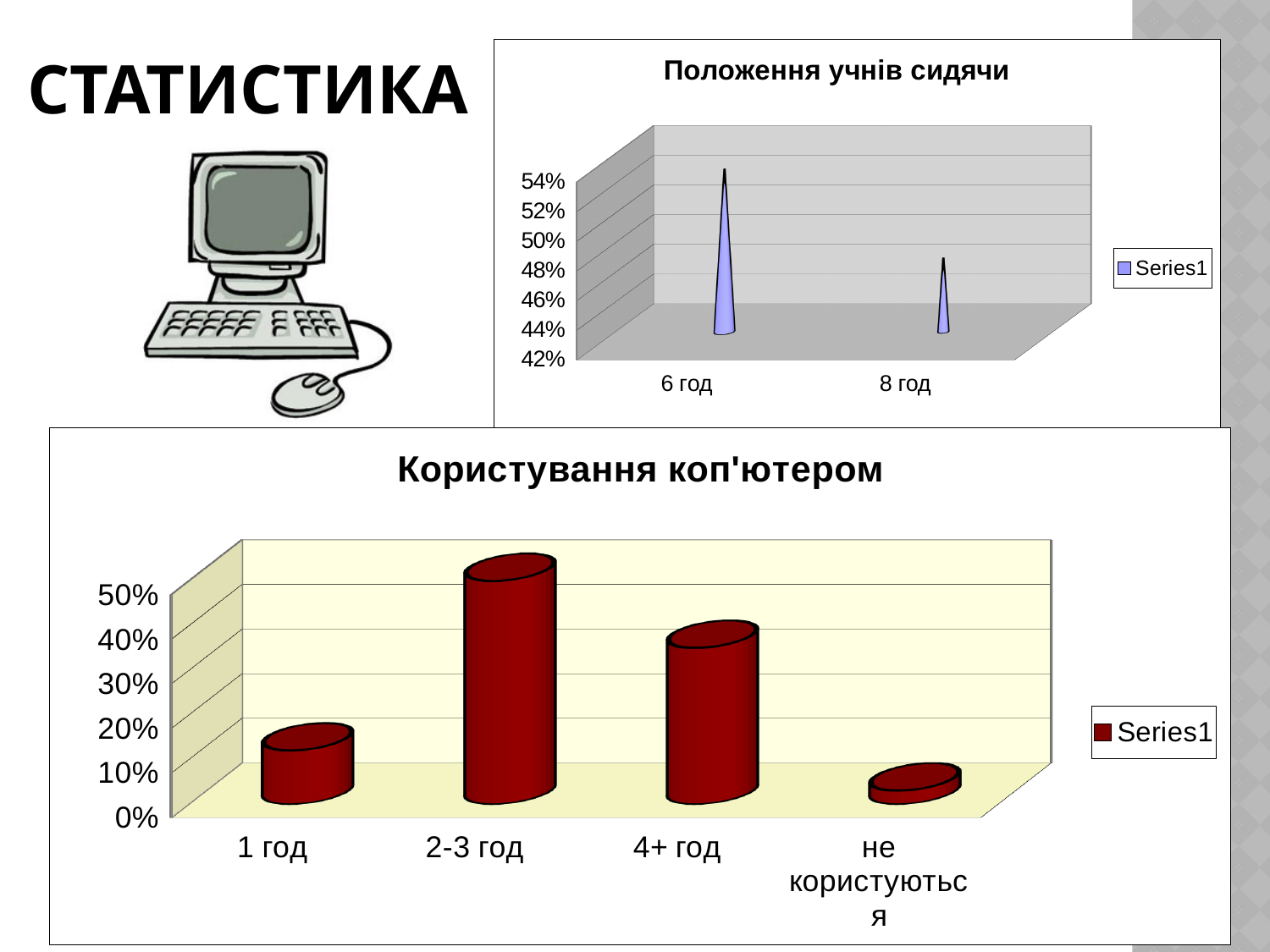
In the chart titled "Користування коп'ютером", how many categories are shown on the x axis? 4 In the chart titled "Користування коп'ютером", which category has the highest value? 2-3 год In the chart titled "Положення учнів сидячи", how many categories are shown on the x axis? 2 In the chart titled "Користування коп'ютером", is the value for 1 год greater or less than 20%? less In the chart titled "Положення учнів сидячи", is the value for 8 год greater or less than 50%? less How many series does the legend of the chart titled "Положення учнів сидячи" list? 1 In the chart titled "Користування коп'ютером", is the value for 4+ год greater or less than 30%? greater What is the title of the chart at the bottom of the slide? Користування коп'ютером In the chart titled "Користування коп'ютером", which is larger: the value for 1 год or the value for 4+ год? 4+ год In the chart titled "Положення учнів сидячи", which category has the higher value? 6 год In the chart titled "Користування коп'ютером", which category has the lowest value? не користуються